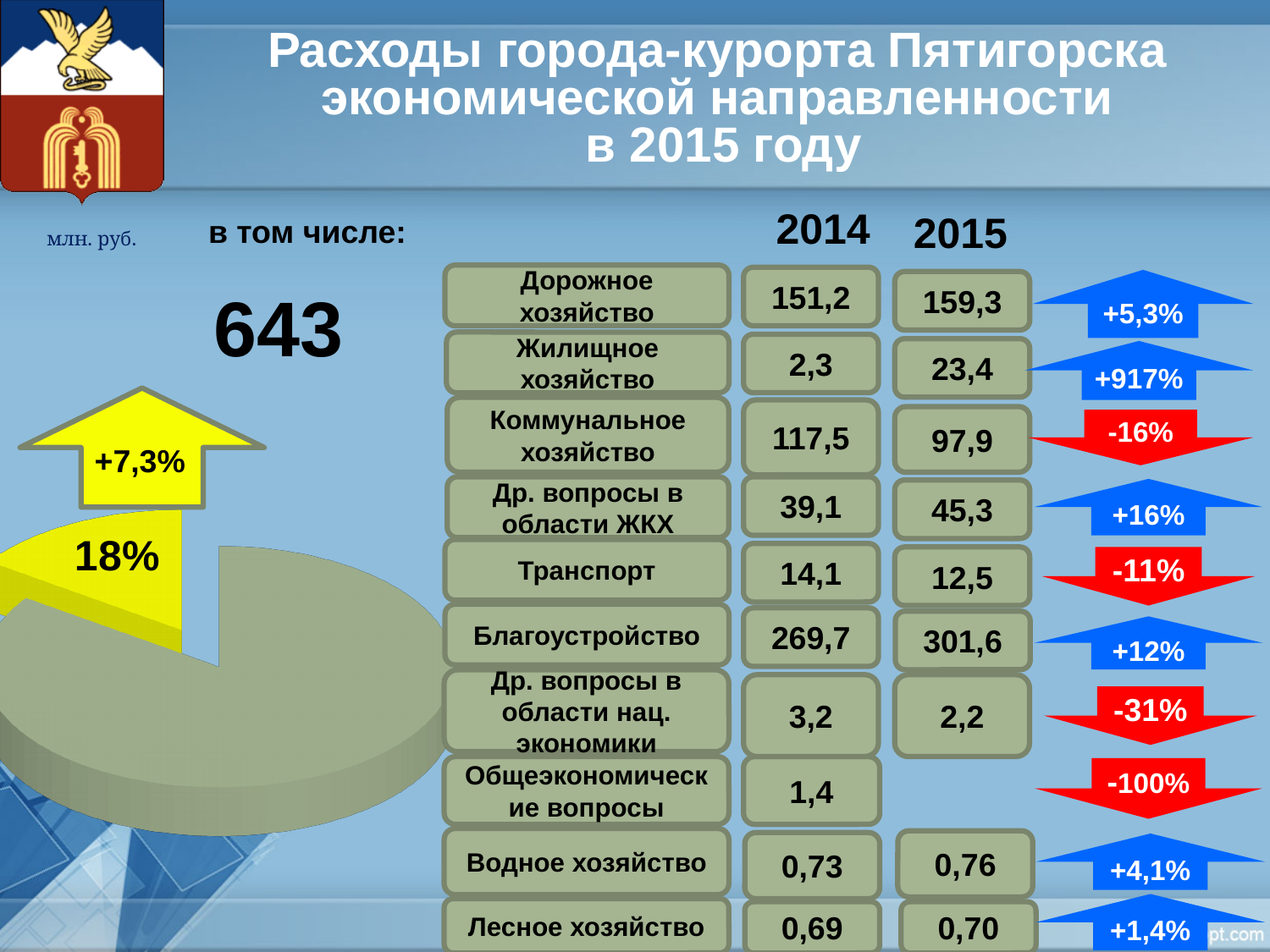
In the table to the right of the pie chart, what is the 2015 value for Благоустройство? 301,6 In the table to the right of the pie chart, what is the 2014 value for Дорожное хозяйство? 151,2 How many slices does the pie chart have? 2 What colour is the exploded slice of the pie chart? yellow What total value (in million rubles) is printed above the pie chart? 643 What share of the pie chart does the exploded yellow slice represent? 18% What unit is indicated at the top left of the slide for the values shown? млн. руб. What percentage change is printed in the yellow arrow next to the pie chart? +7,3% In the table to the right of the pie chart, which category has the highest 2015 value? Благоустройство In the table to the right of the pie chart, what is the percentage change shown for Коммунальное хозяйство? -16% What kind of chart is shown on the left of the slide? pie chart Which slice of the pie chart is larger, the yellow slice or the grey slice? the grey slice